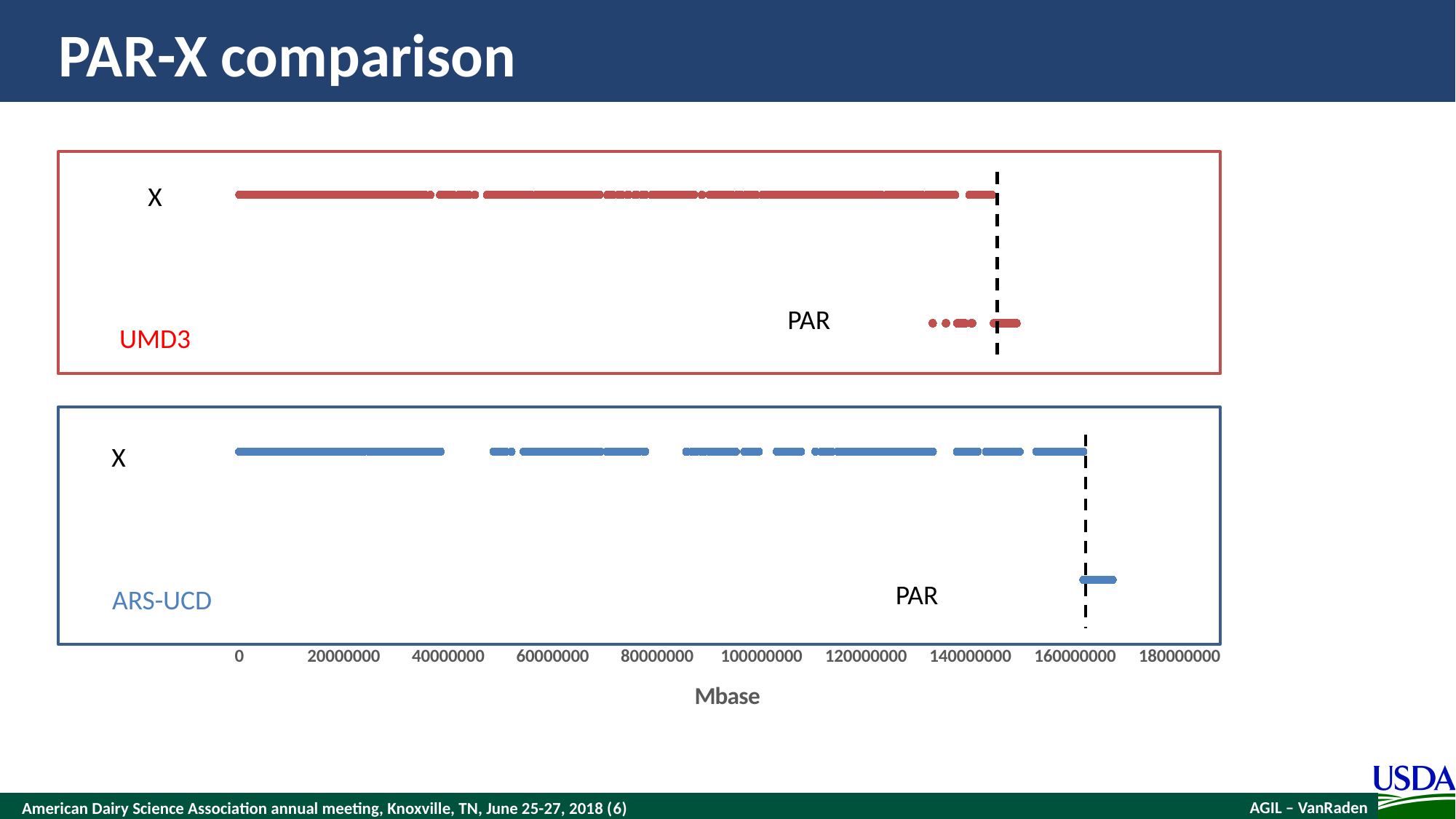
What is the maximum value shown on the x axis of the ARS-UCD chart? 180000000 Which chart's PAR row starts further to the right on the x axis, UMD3 or ARS-UCD? ARS-UCD What is the x-axis title shown below the charts? Mbase What is the title of the slide containing the charts? PAR-X comparison In the UMD3 (top) chart, is the right end of the X row greater or less than 160000000? less In the UMD3 (top) chart, how many rows of data are plotted? 2 Which chart's X row extends further along the x axis, UMD3 or ARS-UCD? ARS-UCD In the UMD3 (top) chart, is the left end of the PAR row greater or less than 120000000? greater What kind of chart is used in the UMD3 panel? scatter chart In the ARS-UCD (bottom) chart, how many rows of data are plotted? 2